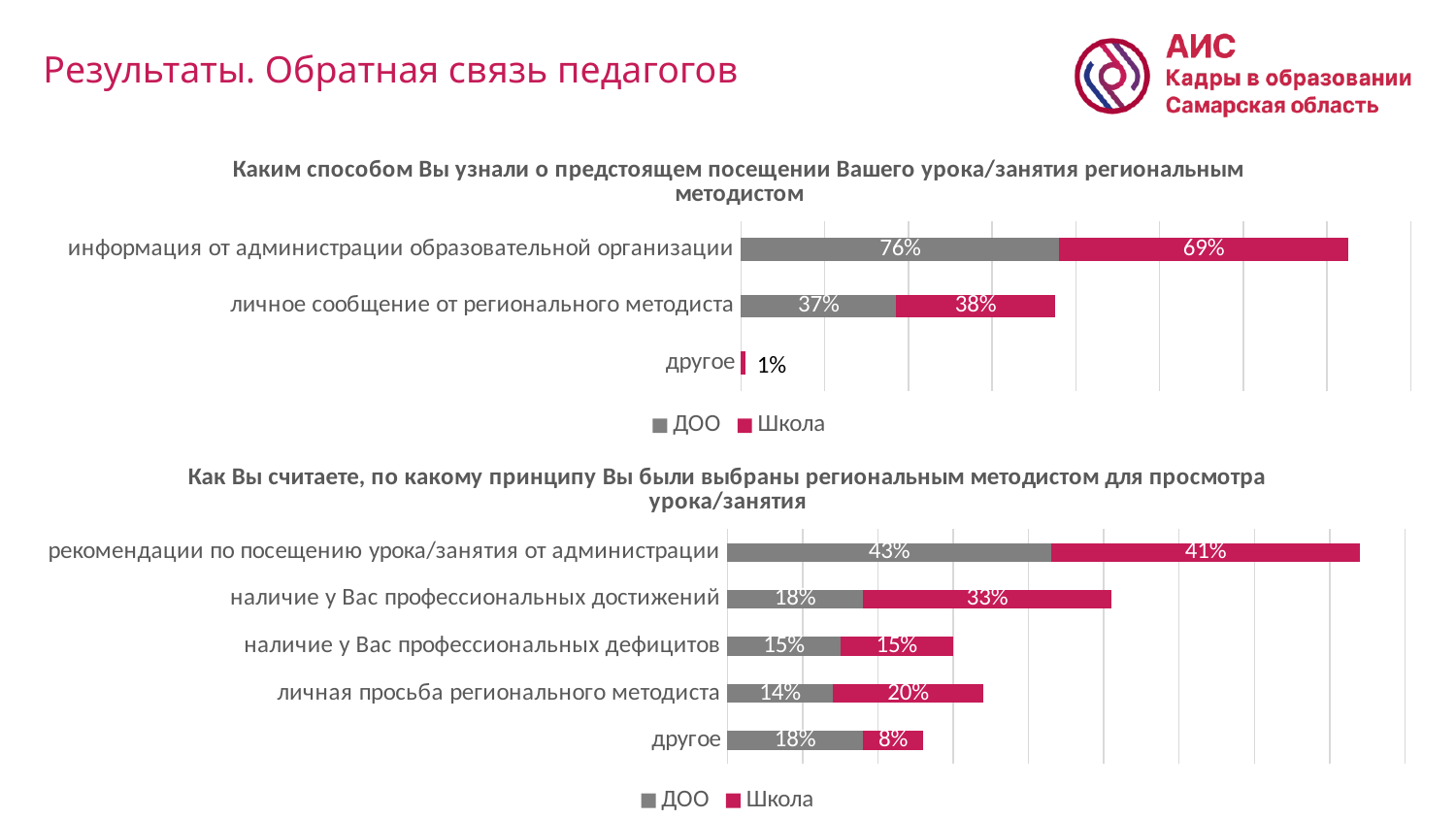
In the bottom chart, what is the ДОО value for 'личная просьба регионального методиста'? 14% In the bottom chart, which is larger for 'другое': the ДОО value or the Школа value? ДОО In the top chart, what is the Школа value for 'личное сообщение от регионального методиста'? 38% What type of chart is the top chart? Stacked bar chart How many series does the legend of the bottom chart list? 2 In the top chart, what is the difference between the ДОО and Школа values for 'информация от администрации образовательной организации'? 7% In the bottom chart, what is the total of the stacked bar for 'рекомендации по посещению урока/занятия от администрации'? 84% In the bottom chart, what is the Школа value for 'наличие у Вас профессиональных достижений'? 33% In the top chart, how many categories are shown? 3 In the top chart, which category has the highest ДОО value? информация от администрации образовательной организации In the bottom chart, how many categories are shown? 5 In the top chart, what is the ДОО value for 'информация от администрации образовательной организации'? 76%